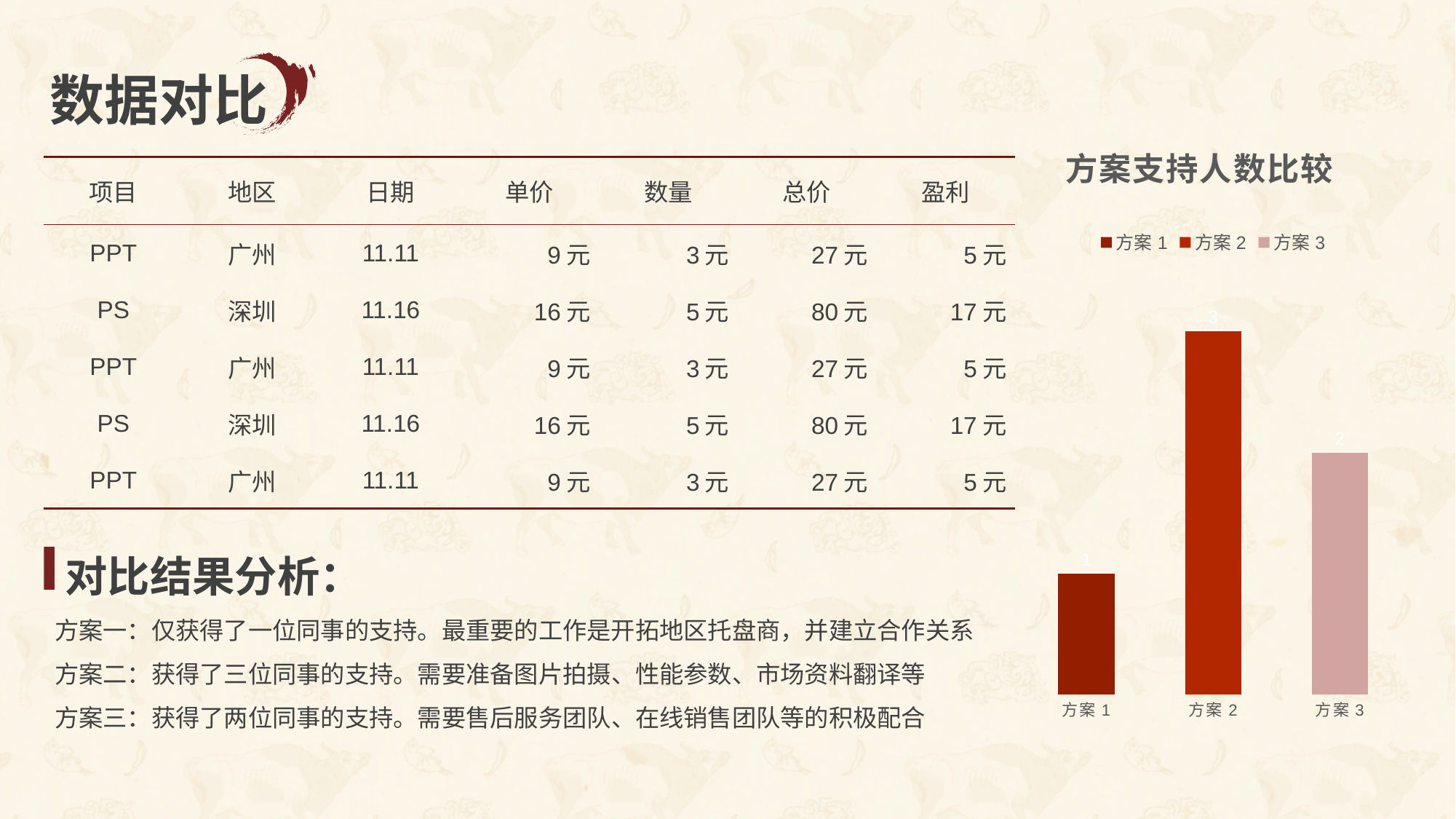
How many entries does the chart legend list? 3 What is the title of the chart? 方案支持人数比较 Which category has the lowest bar in the chart? 方案 1 How many bars are shown in the chart? 3 What is the value for 方案 3 in the chart? 2 What is the value for 方案 1 in the chart? 1 Which is larger, the value for 方案 3 or the value for 方案 1? 方案 3 What is the difference between the values for 方案 3 and 方案 1? 1 What is the difference between the values for 方案 2 and 方案 1? 2 What is the value for 方案 2 in the chart? 3 Which category has the highest bar in the chart? 方案 2 What kind of chart is shown on the slide? Bar chart